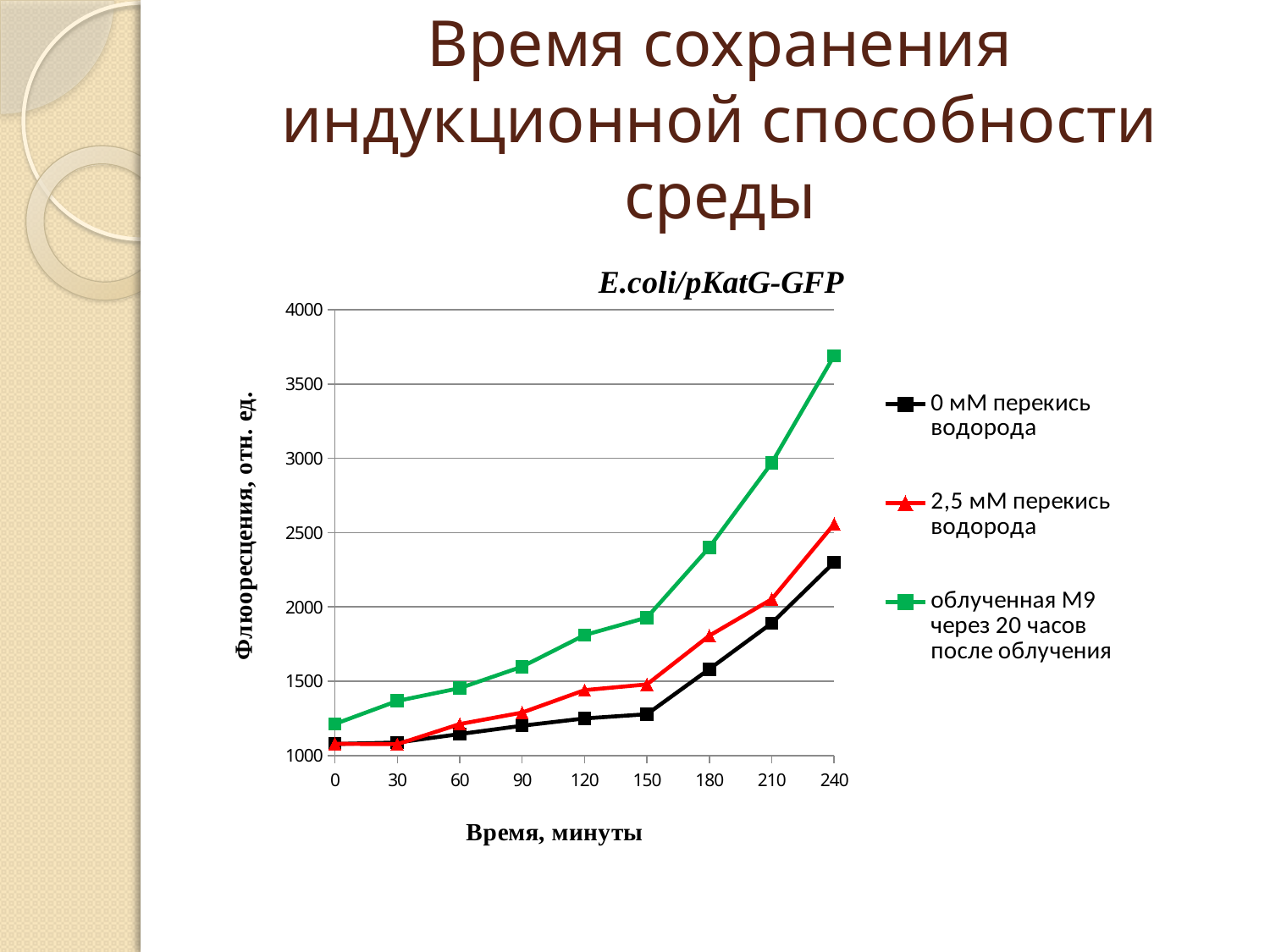
Which series has the lowest value at 240 minutes? 0 мМ перекись водорода Which series has the highest value at 240 minutes? облученная М9 через 20 часов после облучения What is the title of the chart? E.coli/pKatG-GFP Do the values of the 'облученная М9 через 20 часов после облучения' series rise or fall as time increases? rise Is the value for '0 мМ перекись водорода' at 240 minutes greater or less than 2500? less How many series does the legend list? 3 Is the value for 'облученная М9 через 20 часов после облучения' at 240 minutes greater or less than 3500? greater At 240 minutes, which series has the higher value: '0 мМ перекись водорода' or 'облученная М9 через 20 часов после облучения'? облученная М9 через 20 часов после облучения Is the value for '2,5 мМ перекись водорода' at 180 minutes greater or less than 1500? greater What kind of chart is shown on the slide? line chart How many time points are plotted along the x axis? 9